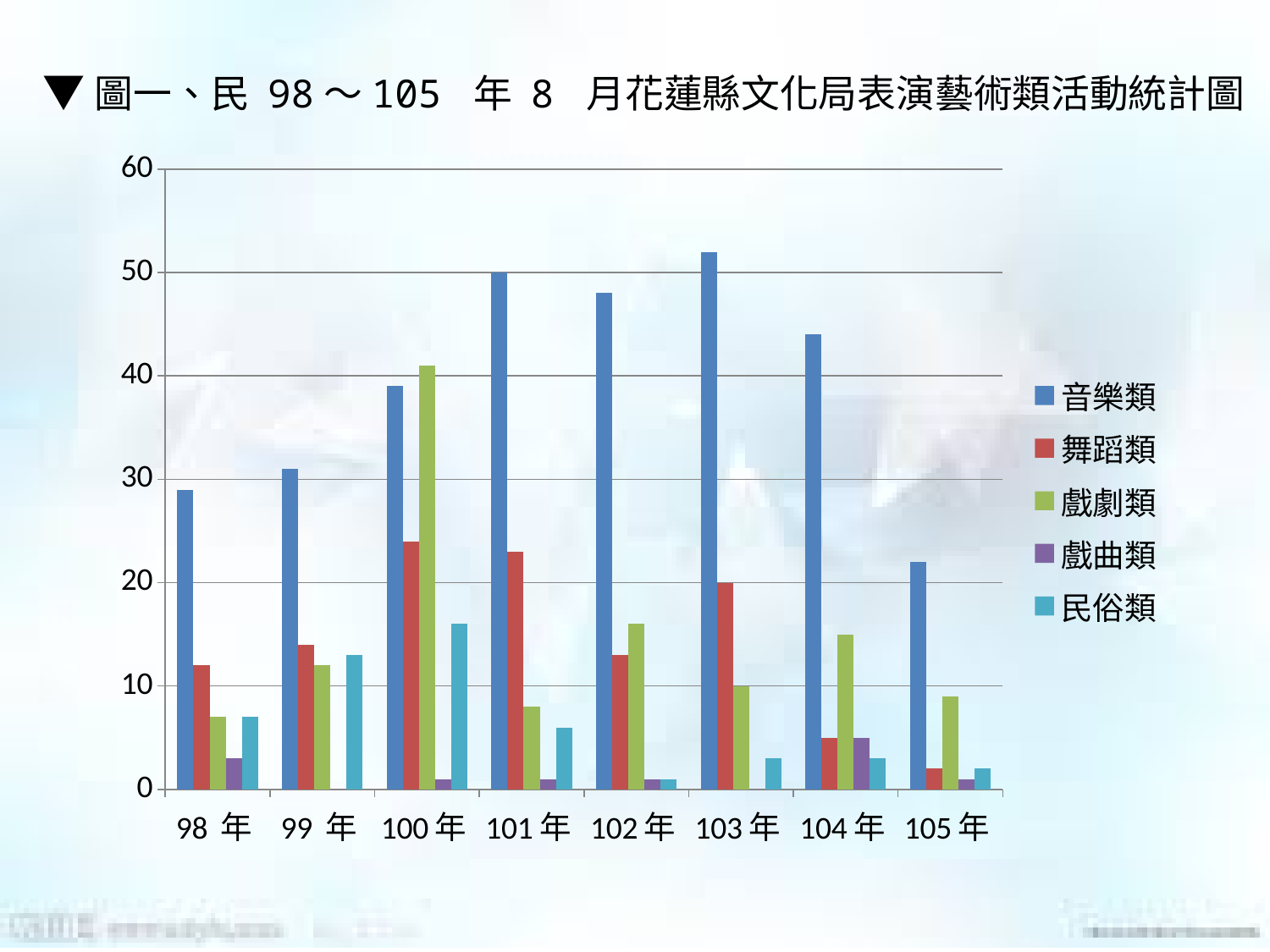
In 104 年, which is larger: 戲劇類 or 舞蹈類? 戲劇類 How many series does the legend list? 5 What kind of chart is shown on the slide? bar chart How many years are shown along the x axis? 8 What colour represents 音樂類 in the legend? blue In 101 年, which is larger: 舞蹈類 or 戲劇類? 舞蹈類 Is the value for 民俗類 in 100 年 greater or less than 10? greater In which year is the 音樂類 bar the lowest? 105 年 Is the value for 音樂類 in 103 年 greater or less than 50? greater Is the value for 音樂類 in 98 年 greater or less than 20? greater In which year is the 戲劇類 bar the highest? 100 年 Does the 音樂類 value rise or fall from 98 年 to 103 年? rise